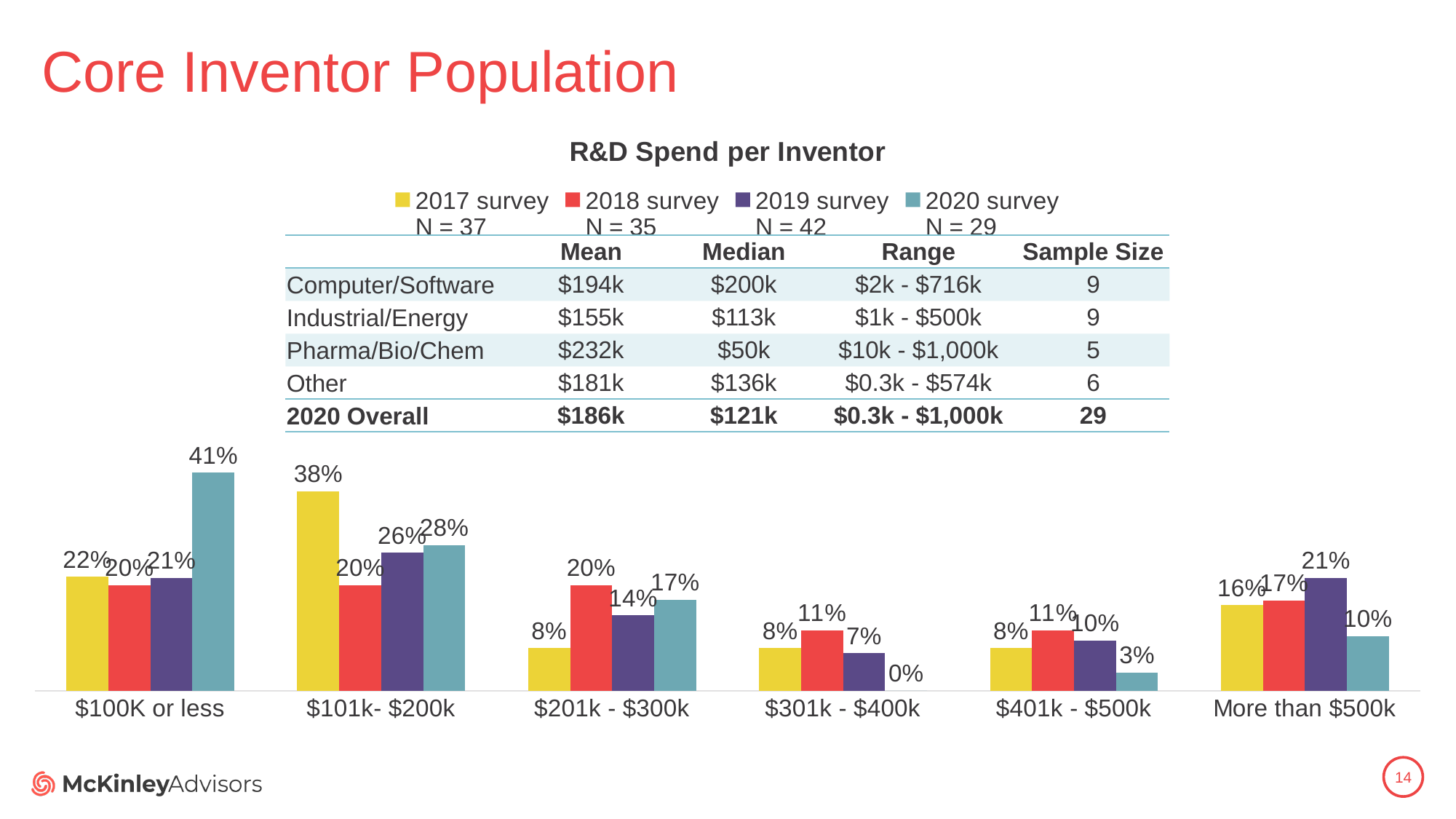
What kind of chart is shown on the slide? Bar chart How many series does the chart legend list? 4 Which is larger for the "$401k - $500k" category: the 2018 survey value or the 2020 survey value? 2018 survey How many spend categories are shown along the x axis of the chart? 6 What is the 2020 survey value for the "$100K or less" category? 41% What is the title of the chart? R&D Spend per Inventor Which survey year has the highest value in the "$201k - $300k" category? 2018 survey What is the 2019 survey value for the "More than $500k" category? 21% What is the 2017 survey value for the "$101k- $200k" category? 38% What is the difference between the 2020 survey and 2017 survey values for the "$100K or less" category? 19% What is the sample size (N) for the 2019 survey shown in the legend? N = 42 Which survey year has the lowest value in the "$301k - $400k" category? 2020 survey